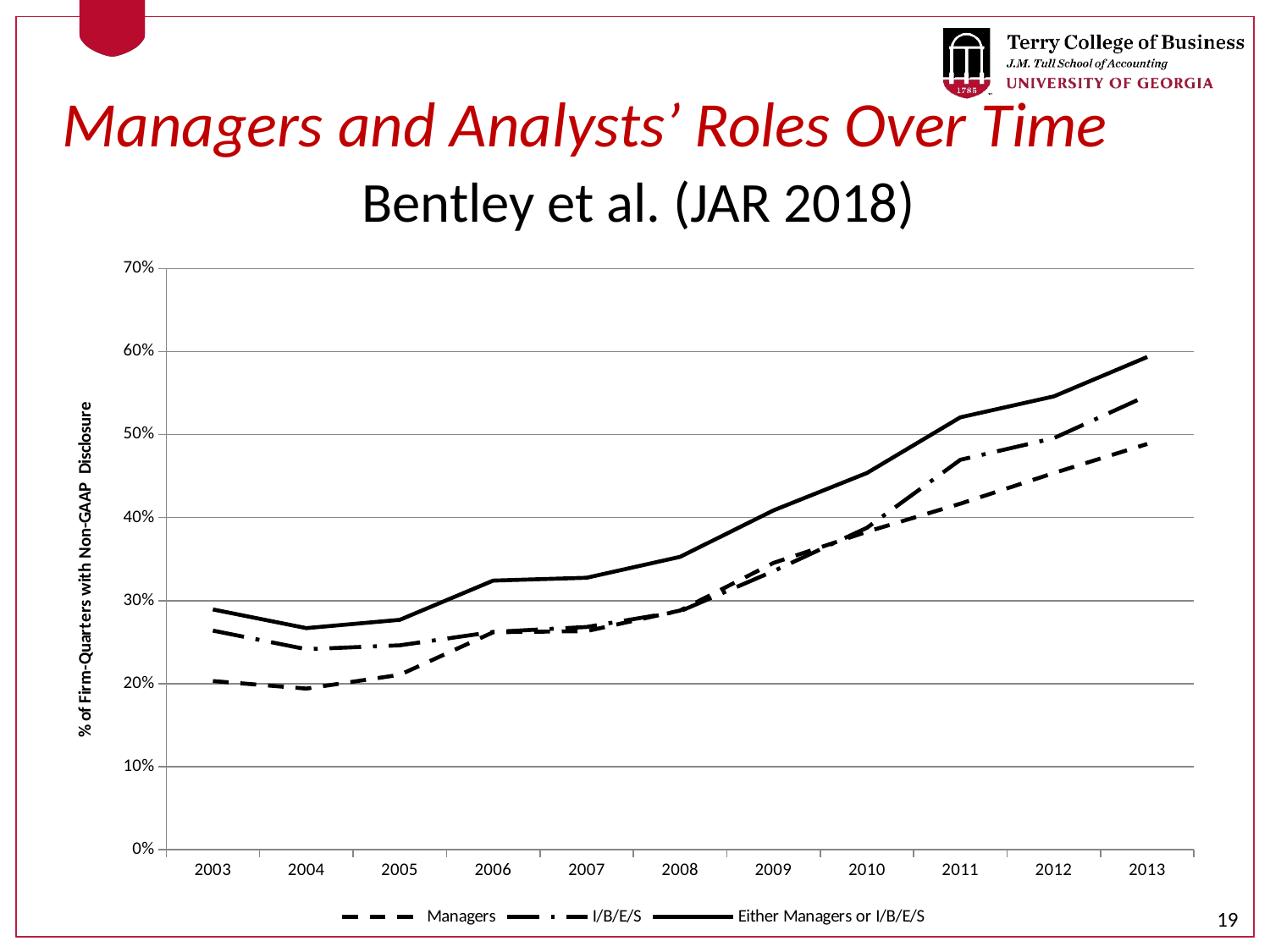
What is the label on the y axis? % of Firm-Quarters with Non-GAAP Disclosure Is the value for 'Either Managers or I/B/E/S' in 2013 greater or less than 50%? greater In 2013, which is larger: the I/B/E/S value or the Managers value? I/B/E/S Which series is drawn with the solid line? Either Managers or I/B/E/S In which year is the 'Either Managers or I/B/E/S' line at its highest? 2013 How many years are plotted along the x axis? 11 How many series does the legend list? 3 What kind of chart is shown on the slide? Line chart In which year is the Managers line at its lowest? 2004 Is the value for Managers in 2003 greater or less than 30%? less Is the value for I/B/E/S in 2011 greater or less than 40%? greater Does the 'Either Managers or I/B/E/S' line rise or fall from 2003 to 2013? Rise